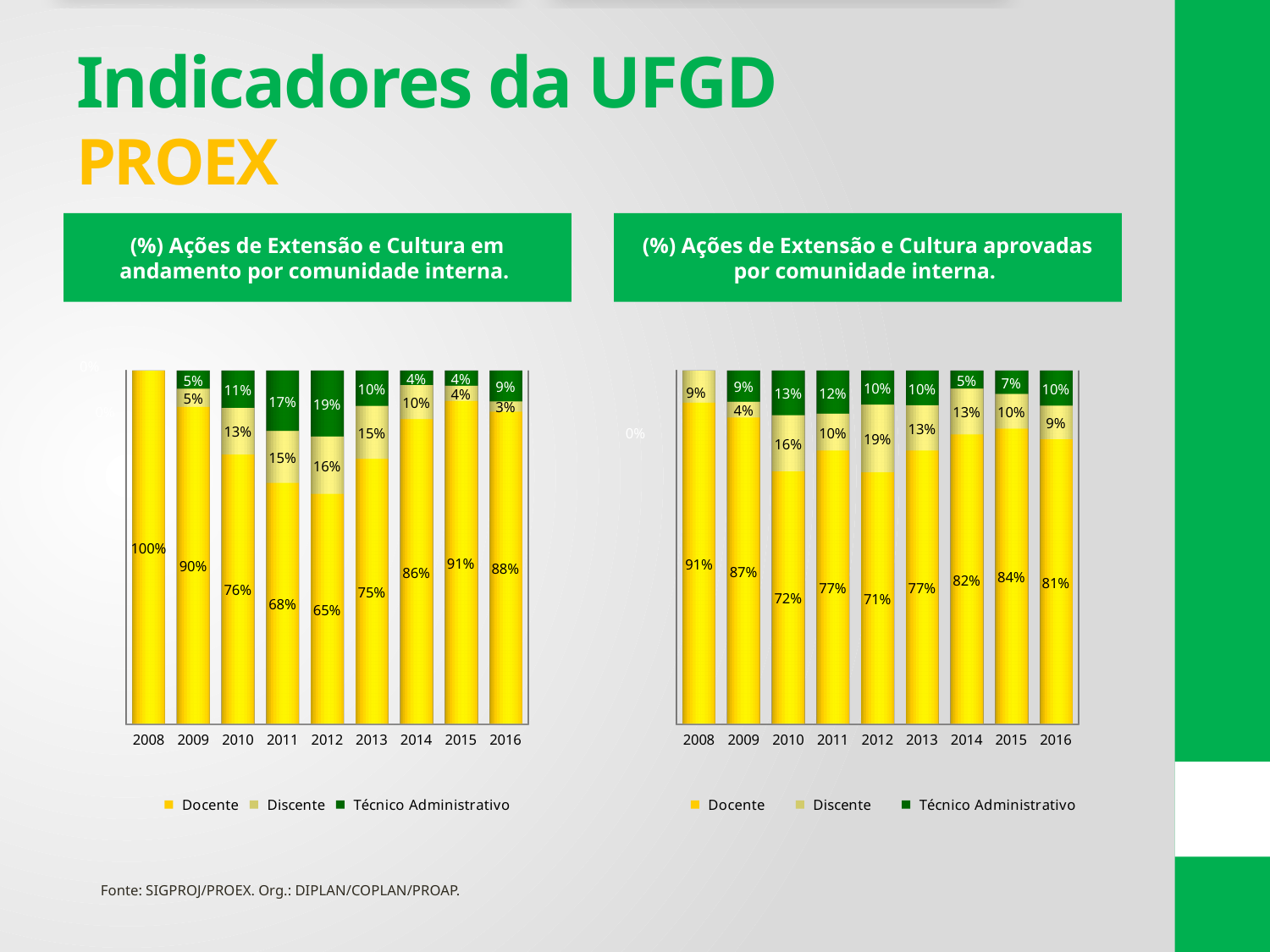
In the left chart (em andamento), does the Docente value rise or fall from 2008 to 2012? Fall How many years are shown on the x axis of the left chart (em andamento)? 9 How many series does the legend of the right chart (aprovadas) list? 3 Which series is shown in dark green in the legend of the left chart (em andamento)? Técnico Administrativo In the right chart (aprovadas), which year has the lowest Docente value? 2012 What kind of chart is the left chart (em andamento)? Stacked bar chart In the left chart (em andamento), what is the difference between the Docente values for 2015 and 2012? 26% In the right chart (Ações de Extensão e Cultura aprovadas), what is the Discente value for 2012? 19% In the left chart (em andamento), which year has the highest Docente value? 2008 In the right chart (aprovadas), which is larger: the Técnico Administrativo value for 2010 or for 2014? 2010 In the left chart (Ações de Extensão e Cultura em andamento), what is the Docente value for 2012? 65% In the right chart (aprovadas), what is the Técnico Administrativo value for 2015? 7%